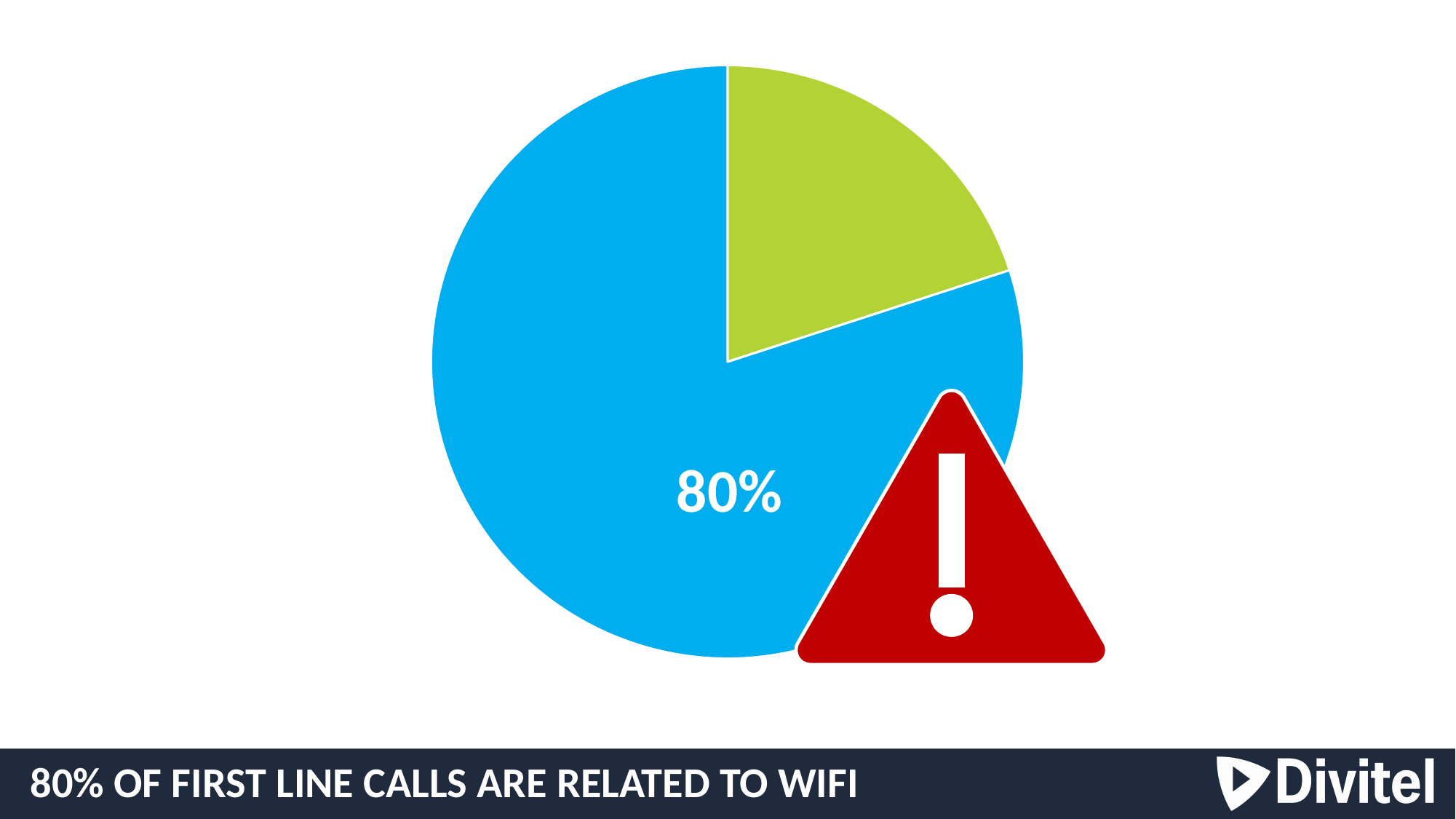
Which slice is larger, the blue slice or the green slice? The blue slice What colour is the slice labelled 80%? Blue Which slice of the pie chart is the smallest? The green slice What share of the pie does the blue slice represent? 80% What does the caption at the bottom of the slide say the 80% represents? 80% of first line calls are related to WiFi What value is printed on the blue slice of the pie chart? 80% Which slice of the pie chart is the largest? The blue slice What kind of chart is shown on the slide? Pie chart How many slices does the pie chart have? 2